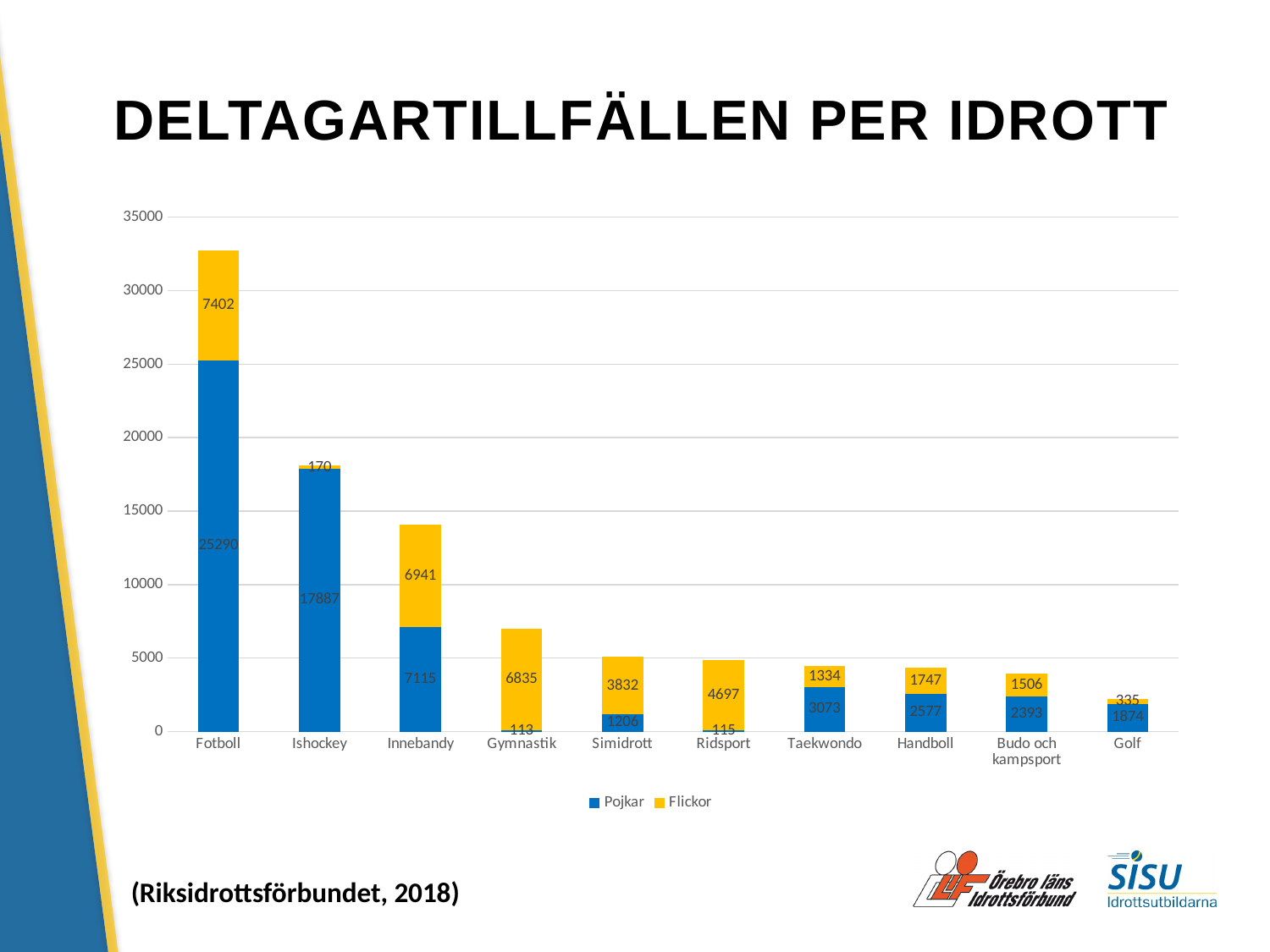
What is the total of the stacked bar for Handboll? 4324 How many sports (categories) are shown on the x axis? 10 How many series does the legend list? 2 What kind of chart is shown on the slide? Stacked bar chart What is the Pojkar value for Taekwondo? 3073 What is the Pojkar value for Fotboll? 25290 What is the Flickor value for Innebandy? 6941 Which sport has the lowest total stacked bar? Golf Which sport has the highest total stacked bar? Fotboll What is the Flickor value for Ishockey? 170 What is the difference between the Flickor value for Fotboll and the Flickor value for Innebandy? 461 Is the Pojkar value for Innebandy larger or smaller than the Pojkar value for Golf? Larger